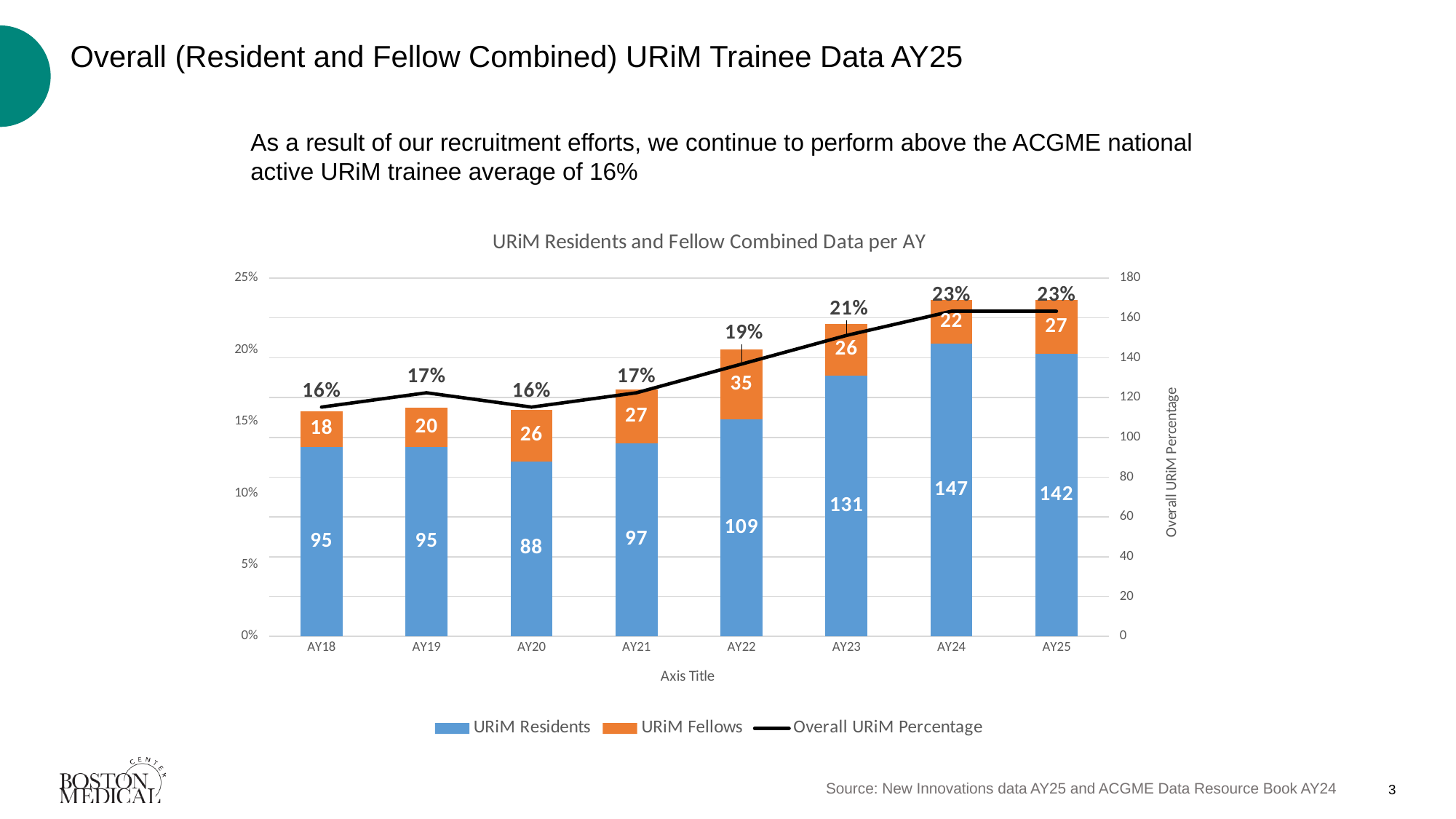
Is the value for URiM Fellows larger in AY20 or AY24? AY20 What is the difference between URiM Residents in AY24 and AY25? 5 What is the value for URiM Residents in AY23? 131 What is the total of the stacked bar for AY25? 169 What is the title of the chart? URiM Residents and Fellow Combined Data per AY What is the value for URiM Fellows in AY22? 35 How many academic years are shown on the x axis? 8 What is the Overall URiM Percentage for AY21? 17% Which academic year has the highest value for URiM Fellows? AY22 Which academic year has the highest value for URiM Residents? AY24 How many series does the legend list? 3 Which academic year has the lowest value for URiM Residents? AY20